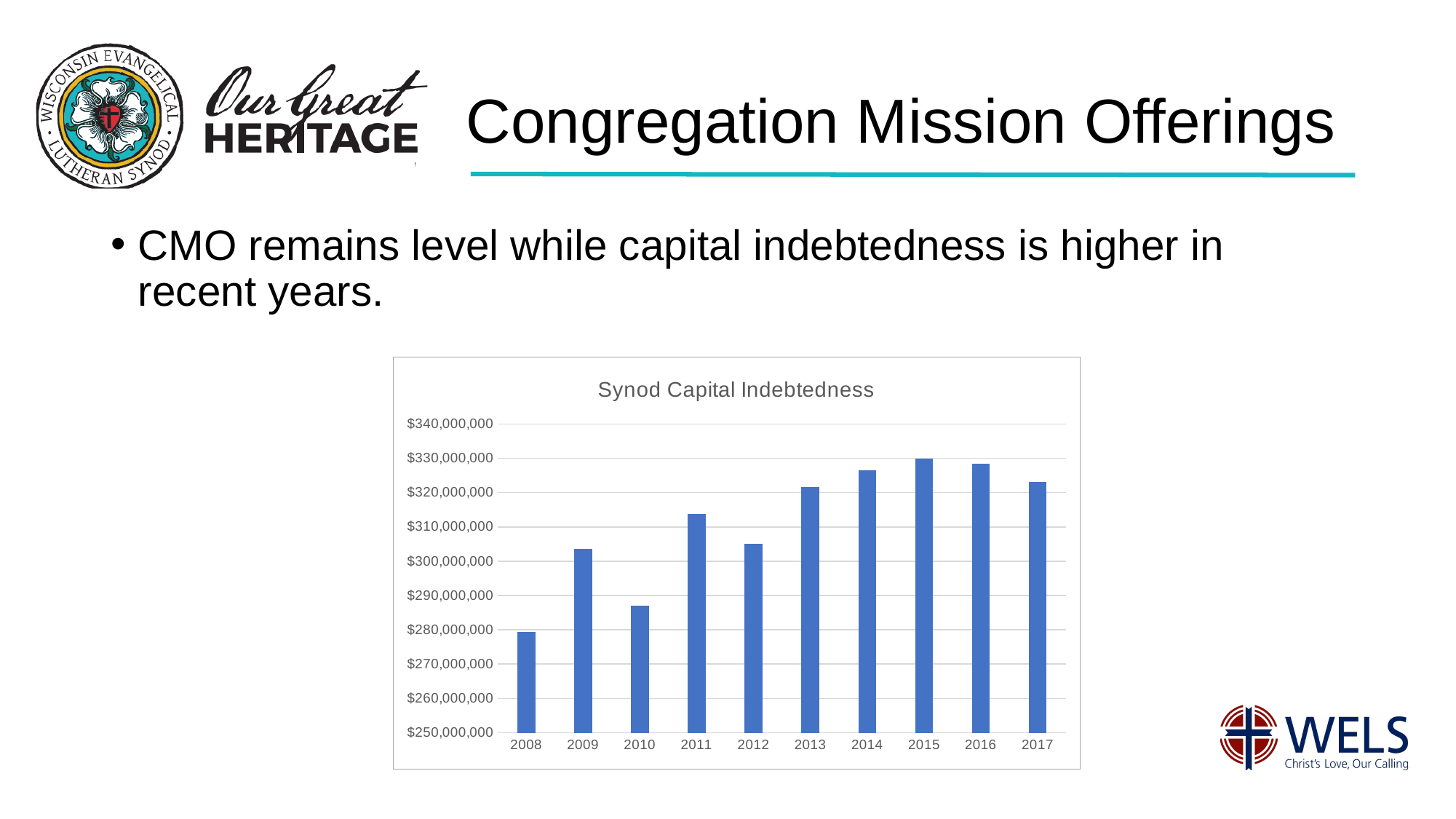
What is the title of the chart on the slide? Synod Capital Indebtedness What kind of chart is shown on the slide? Bar chart Is the Synod Capital Indebtedness for 2012 greater or less than $300,000,000? greater Which year has the higher Synod Capital Indebtedness, 2011 or 2012? 2011 How many years are shown on the x axis of the Synod Capital Indebtedness chart? 10 Is the Synod Capital Indebtedness for 2011 greater or less than $310,000,000? greater Which year has the higher Synod Capital Indebtedness, 2009 or 2010? 2009 Is the Synod Capital Indebtedness for 2013 greater or less than $320,000,000? greater Which year has the lowest Synod Capital Indebtedness? 2008 Does the Synod Capital Indebtedness generally rise or fall from 2008 to 2015? Rise